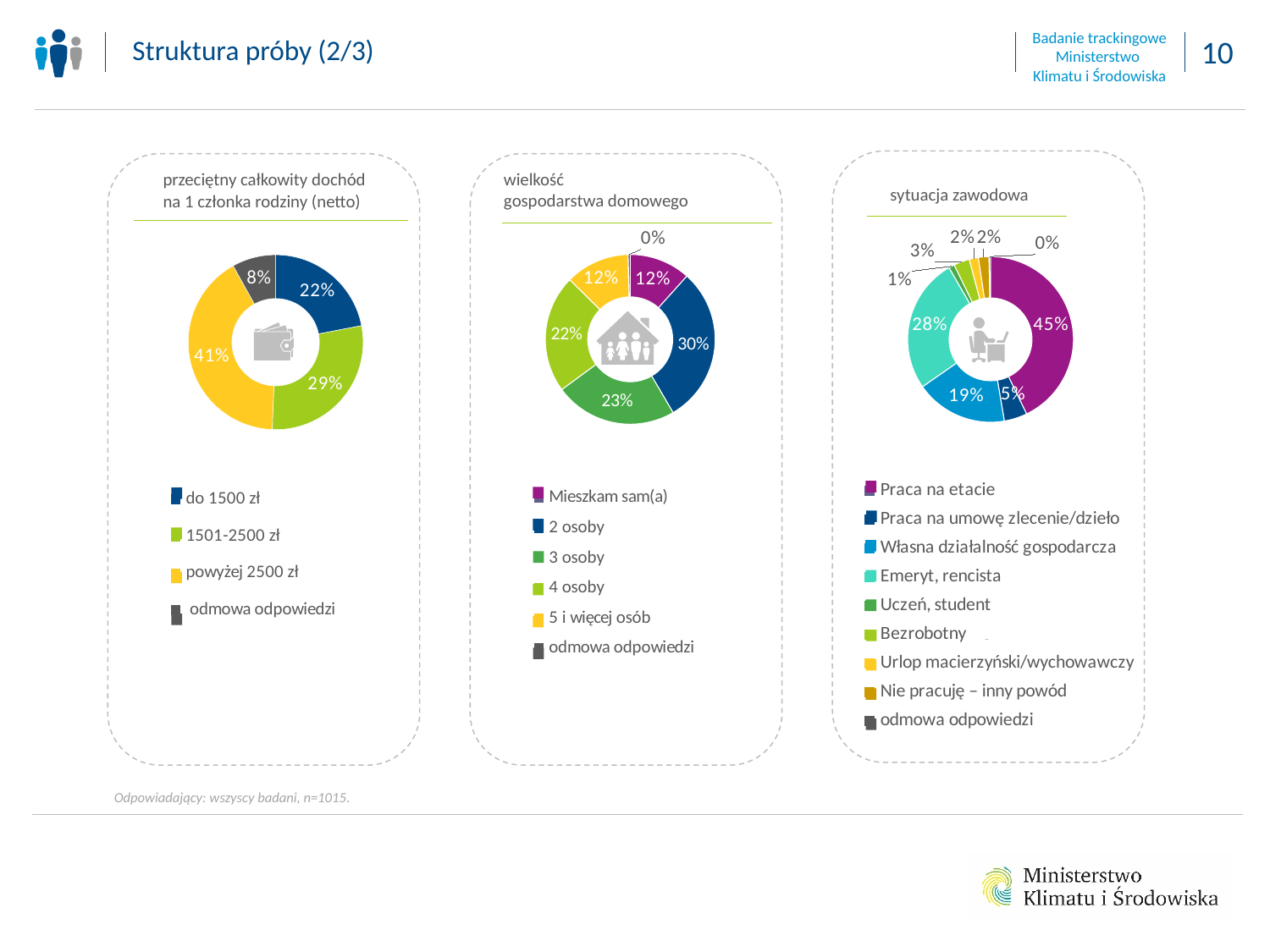
In the chart titled 'wielkość gospodarstwa domowego', which is larger: the share for '3 osoby' or for '4 osoby'? 3 osoby In the chart titled 'wielkość gospodarstwa domowego', which category has the largest share? 2 osoby In the chart titled 'przeciętny całkowity dochód na 1 członka rodziny (netto)', which category has the smallest share? odmowa odpowiedzi In the chart titled 'sytuacja zawodowa', what is the difference between the shares for 'Praca na etacie' and 'Własna działalność gospodarcza'? 26 percentage points In the chart titled 'sytuacja zawodowa', what share is shown for 'Emeryt, rencista'? 28% How many categories does the legend of the chart titled 'wielkość gospodarstwa domowego' list? 6 In the chart titled 'sytuacja zawodowa', which category has the largest share? Praca na etacie In the chart titled 'przeciętny całkowity dochód na 1 członka rodziny (netto)', what share is shown for 'powyżej 2500 zł'? 41% In the chart titled 'przeciętny całkowity dochód na 1 członka rodziny (netto)', what is the difference between the shares for '1501-2500 zł' and 'do 1500 zł'? 7 percentage points In the chart titled 'wielkość gospodarstwa domowego', what share is shown for '2 osoby'? 30% What type of chart is used for 'sytuacja zawodowa'? Donut (pie) chart How many categories does the legend of the chart titled 'sytuacja zawodowa' list? 9